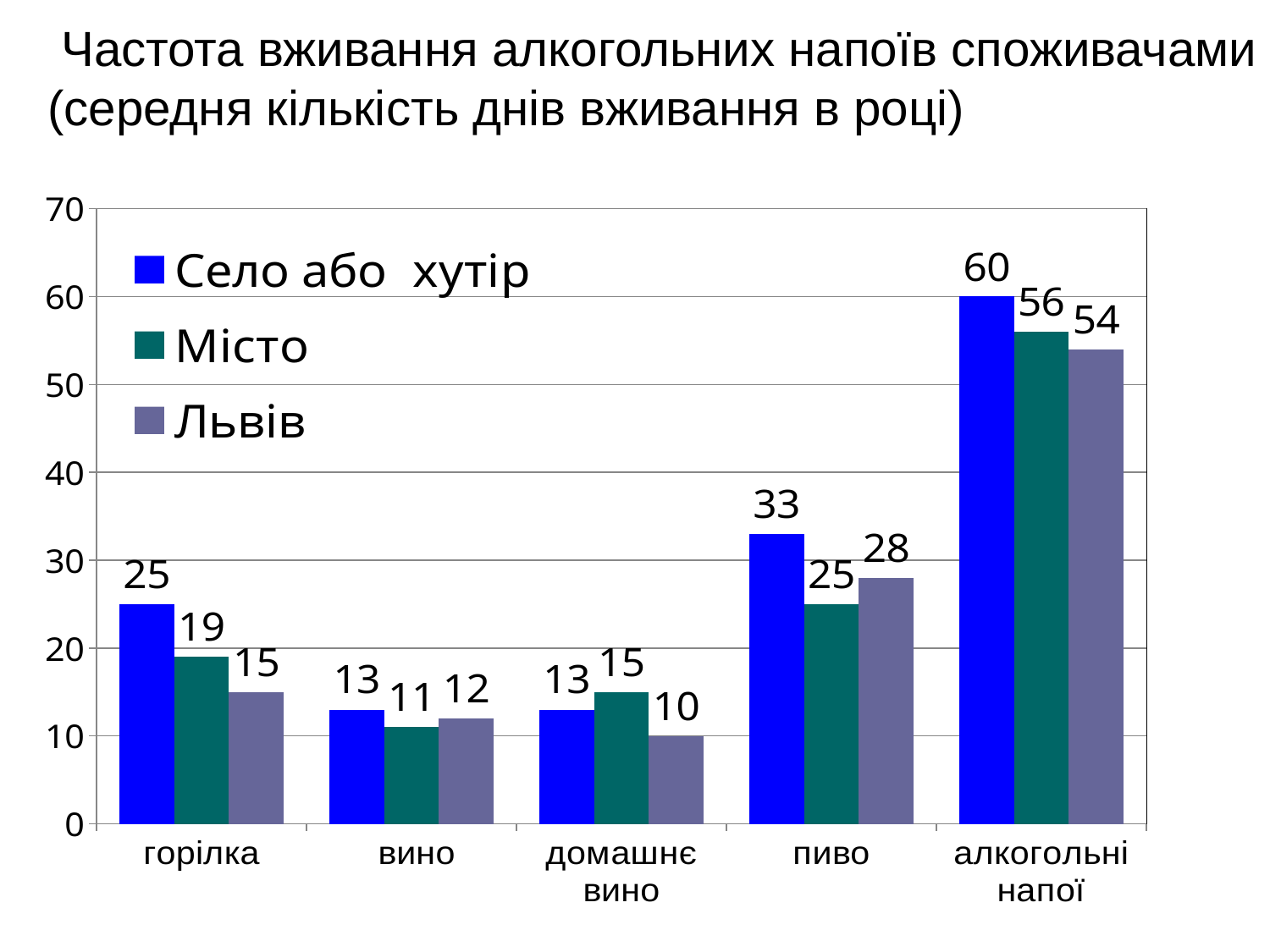
How many series does the legend list? 3 Which category has the lowest value for the Львів series? домашнє вино Which is larger in the домашнє вино category: Місто or Львів? Місто What is the value for Місто in the алкогольні напої category? 56 What is the value for Село або хутір in the горілка category? 25 What kind of chart is shown on the slide? bar chart What is the value for Львів in the пиво category? 28 Is the value for Місто in the пиво category greater or less than 30? less Which category has the highest value for the Село або хутір series? алкогольні напої How many categories are shown on the x axis? 5 Which series is shown in blue in the legend? Село або хутір What is the difference between Село або хутір and Львів in the алкогольні напої category? 6